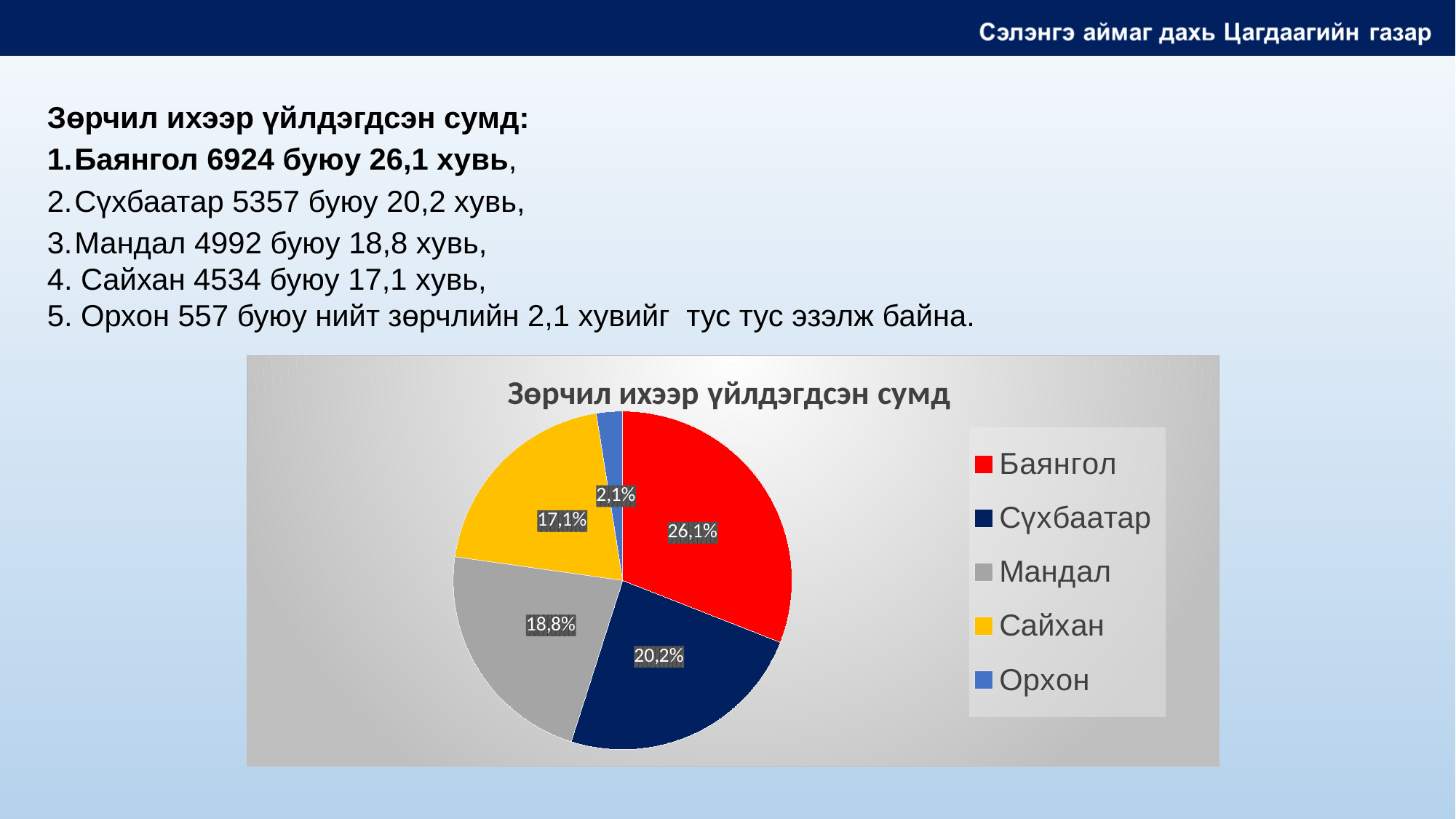
Which category has the smallest slice of the pie? Орхон What share of the pie does Мандал have? 18,8% What share of the pie does Сайхан have? 17,1% What share of the pie does Орхон have? 2,1% What colour is the slice for Сайхан? yellow What kind of chart is shown on the slide? pie chart Which category has the largest slice of the pie? Баянгол Which is larger, the share for Мандал or the share for Сайхан? Мандал What is the title of the chart? Зөрчил ихээр үйлдэгдсэн сумд How many categories does the pie chart show? 5